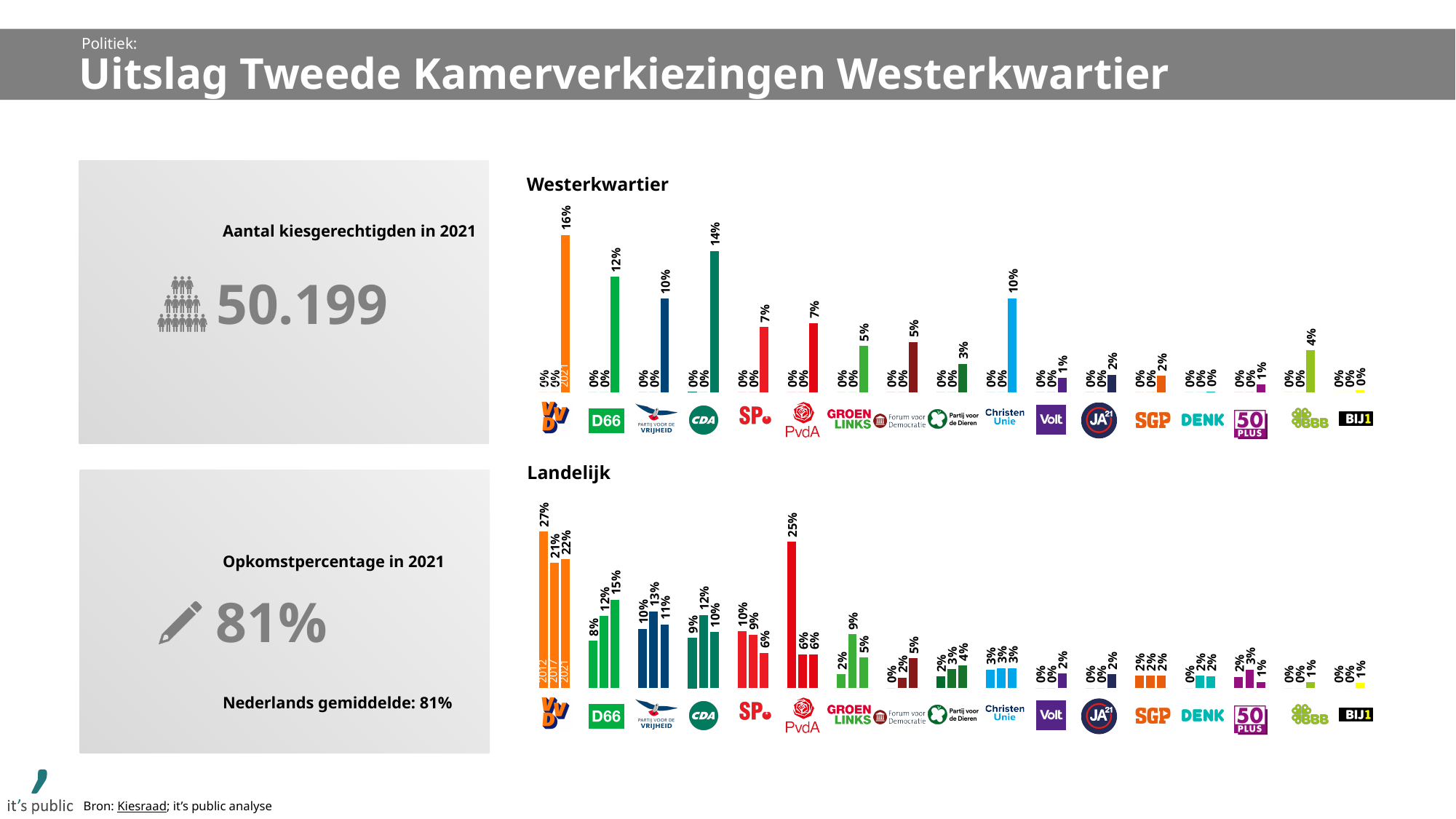
In the Landelijk chart, what is the difference between the 2012 and 2021 values for VVD? 5% In the Westerkwartier chart, which party has the highest 2021 value? VVD In the Landelijk chart, what is the 2012 value for PvdA? 25% In the Westerkwartier chart, what is the 2021 value for VVD? 16% In the Landelijk chart, do the values for D66 rise or fall from 2012 to 2021? rise In the Westerkwartier chart, which is larger in 2021: ChristenUnie or SP? ChristenUnie In the Westerkwartier chart, what is the 2021 value for CDA? 14% In the Landelijk chart, what is the 2021 value for D66? 15% In the Landelijk chart, do the values for SP rise or fall from 2012 to 2021? fall In the Landelijk chart, which party has the highest 2021 value? VVD What kind of chart is the Landelijk chart? bar chart In the Westerkwartier chart, what is the difference between the 2021 values for VVD and D66? 4%